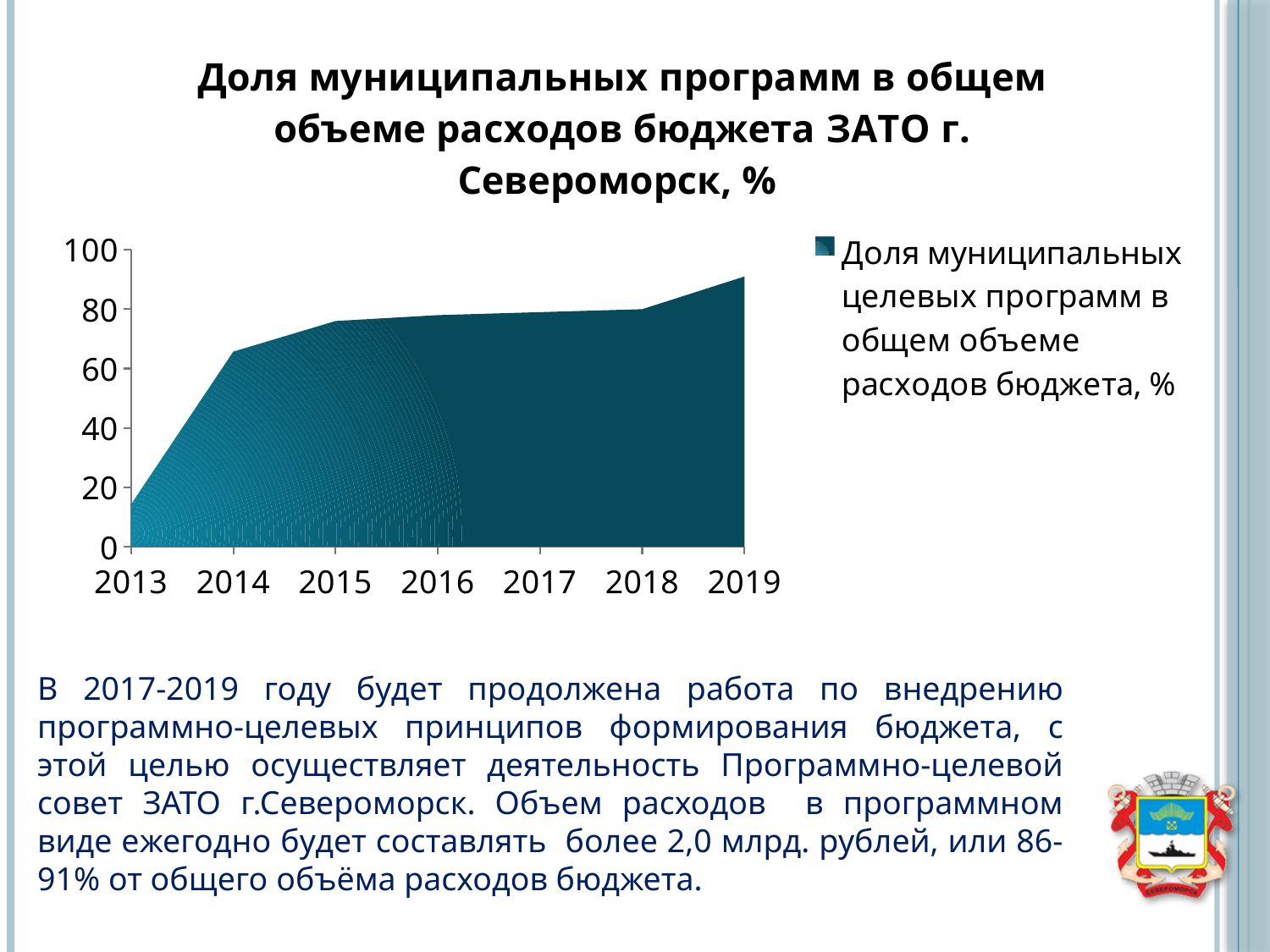
Which is larger, the value for 2014 or the value for 2019? 2019 Is the value for 2015 greater or less than 80? less How many years are plotted along the x axis of the chart? 7 How many series does the chart legend list? 1 What kind of chart is shown on the slide? area chart What is the legend entry of the plotted series? Доля муниципальных целевых программ в общем объеме расходов бюджета, % Which year has the highest share of municipal programmes in total budget expenditure? 2019 Is the value for 2013 greater or less than 20? less Which year has the lowest share of municipal programmes in total budget expenditure? 2013 Is the value for 2019 greater or less than 80? greater Do the values rise or fall from 2013 to 2019? rise